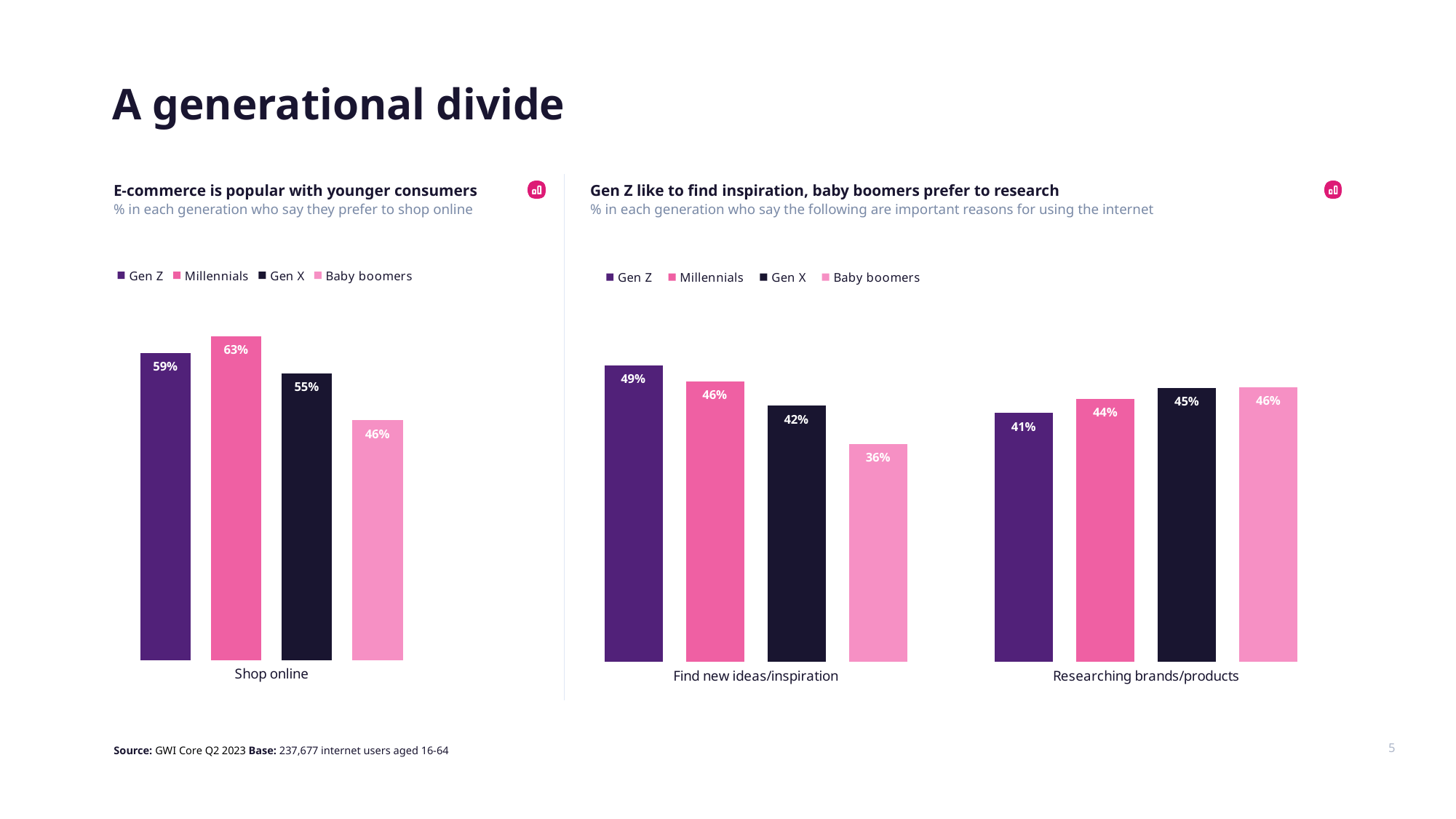
In the right chart 'Gen Z like to find inspiration, baby boomers prefer to research', which is larger for Gen X: Find new ideas/inspiration or Researching brands/products? Researching brands/products In the right chart 'Gen Z like to find inspiration, baby boomers prefer to research', what colour represents Gen X in the legend? Dark navy In the right chart 'Gen Z like to find inspiration, baby boomers prefer to research', which generation has the lowest value for Find new ideas/inspiration? Baby boomers What kind of chart is the left chart 'E-commerce is popular with younger consumers'? Bar chart In the right chart 'Gen Z like to find inspiration, baby boomers prefer to research', what is the Gen Z value for Find new ideas/inspiration? 49% In the left chart 'E-commerce is popular with younger consumers', how many series does the legend list? 4 In the left chart 'E-commerce is popular with younger consumers', what is the difference between the Millennials and Baby boomers values? 17 percentage points In the left chart 'E-commerce is popular with younger consumers', what percentage of Millennials say they prefer to shop online? 63% In the left chart 'E-commerce is popular with younger consumers', which generation has the lowest value for Shop online? Baby boomers In the right chart 'Gen Z like to find inspiration, baby boomers prefer to research', what is the Baby boomers value for Researching brands/products? 46% In the right chart 'Gen Z like to find inspiration, baby boomers prefer to research', what is the difference between the Gen Z and Baby boomers values for Find new ideas/inspiration? 13 percentage points In the right chart 'Gen Z like to find inspiration, baby boomers prefer to research', how many categories are shown on the x axis? 2